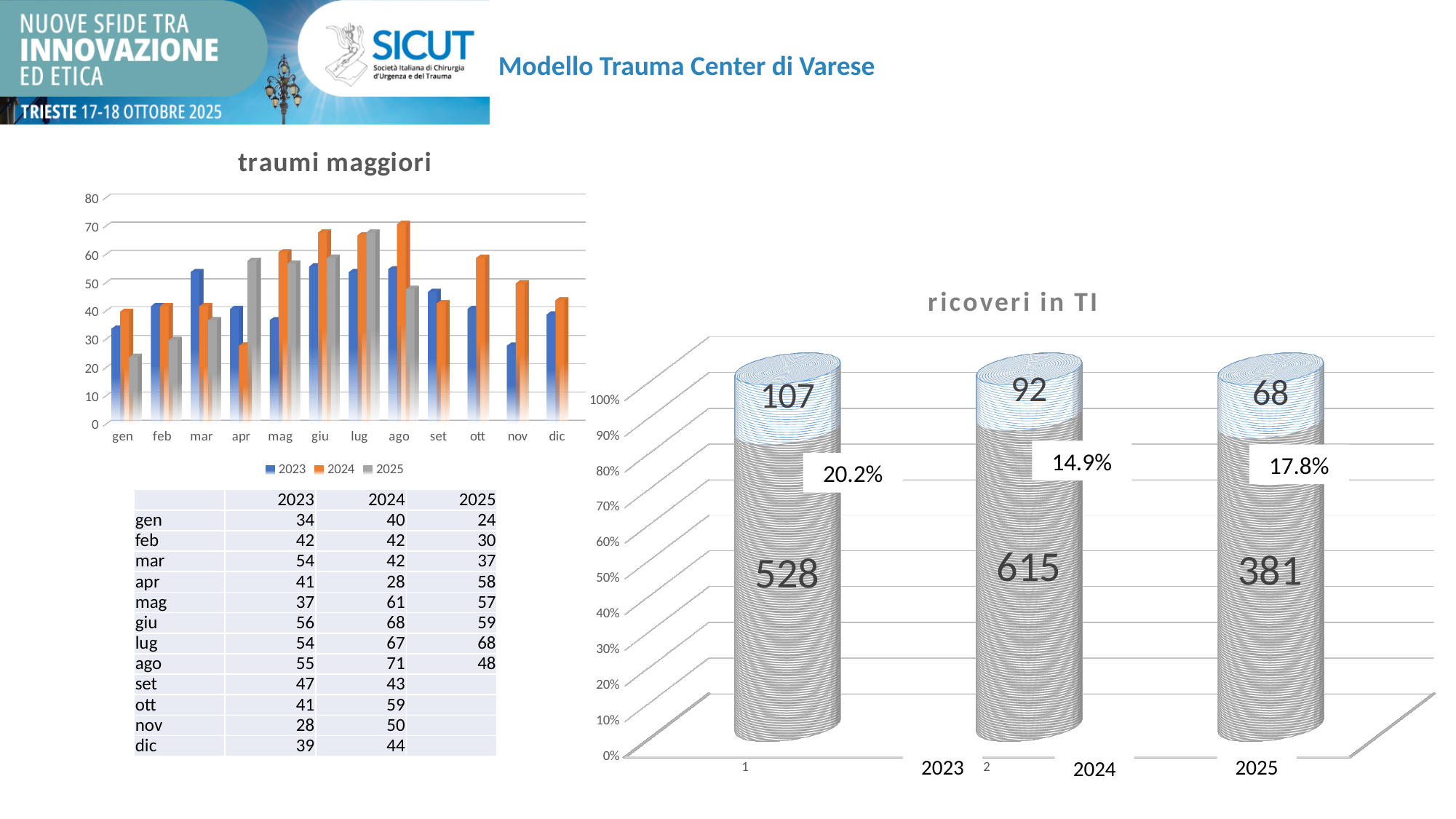
In the 'traumi maggiori' chart, which is larger in apr: the 2023 value or the 2025 value? 2025 In the 'traumi maggiori' chart, what is the value for 2024 in ago? 71 In the 'traumi maggiori' chart, which month has the lowest value for 2023? nov In the 'traumi maggiori' chart, what kind of chart is it? bar chart In the 'traumi maggiori' chart, what is the value for 2025 in lug? 68 In the 'traumi maggiori' chart, what is the difference between the 2024 and 2023 values in giu? 12 In the 'ricoveri in TI' chart, what percentage is shown for 2023? 20.2% In the 'traumi maggiori' chart, how many series does the legend list? 3 In the 'traumi maggiori' chart, which month has the highest value for 2024? ago In the 'traumi maggiori' chart, how many months are shown on the x axis? 12 In the 'ricoveri in TI' chart, what is the total of the two segments for 2025? 449 In the 'ricoveri in TI' chart, what is the value of the top (light blue) segment for 2024? 92